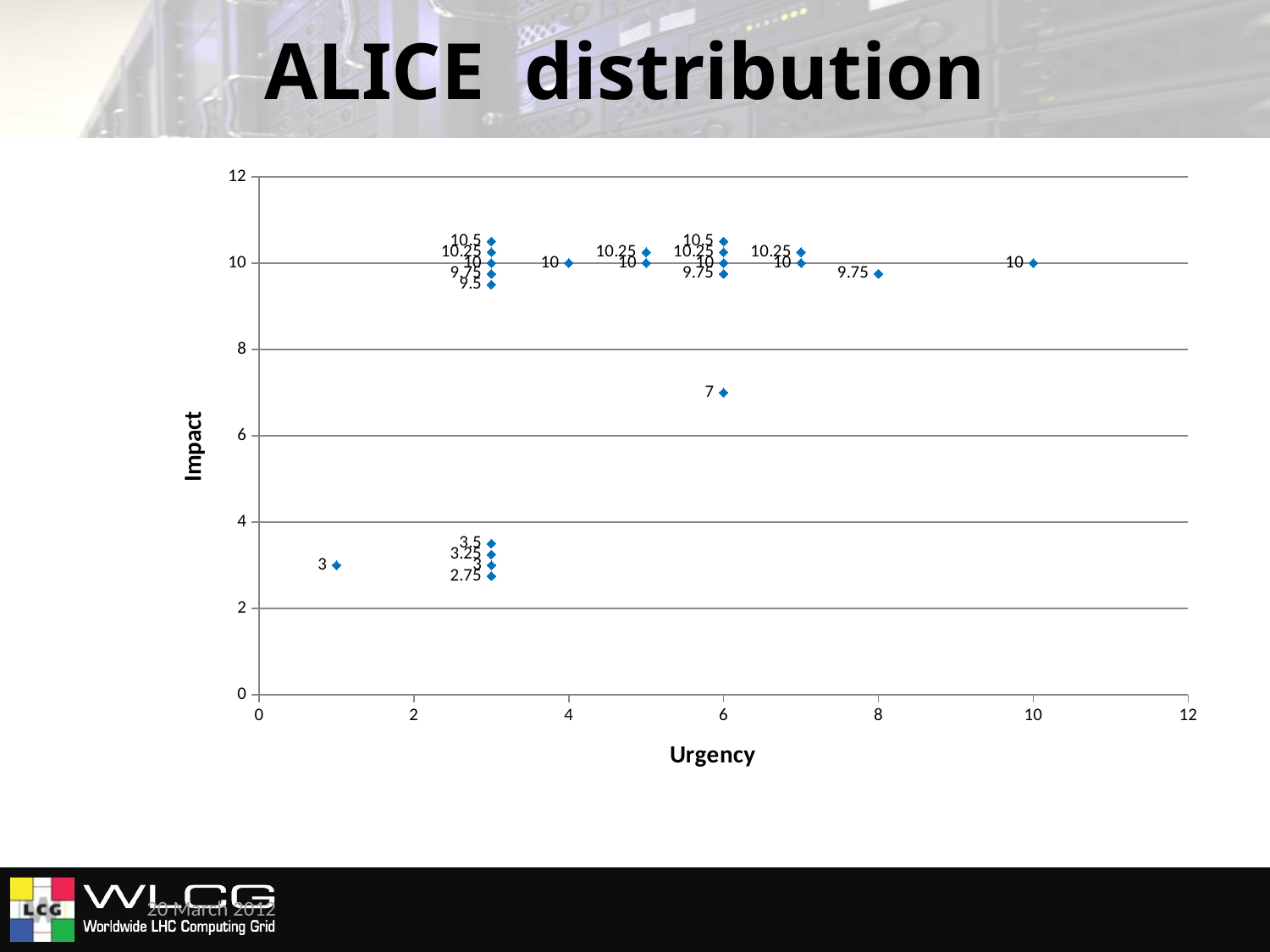
What is the Impact value of the point at Urgency 10? 10 What is the highest Impact value labelled on the chart? 10.5 What is the Impact value of the point at Urgency 4? 10 Which has the larger Impact: the point at Urgency 8 or the point at Urgency 10? the point at Urgency 10 What is the title of the chart? ALICE distribution What is the lowest Impact value labelled on the chart? 2.75 What is the lowest Impact value labelled among the points at Urgency 6? 7 What are the x-axis and y-axis titles of the chart? Urgency (x-axis) and Impact (y-axis) What is the difference in Impact between the point at Urgency 10 and the point at Urgency 1? 7 What is the Impact value of the point at Urgency 8? 9.75 What is the Impact value of the point at Urgency 1? 3 What kind of chart is shown on the slide? scatter chart